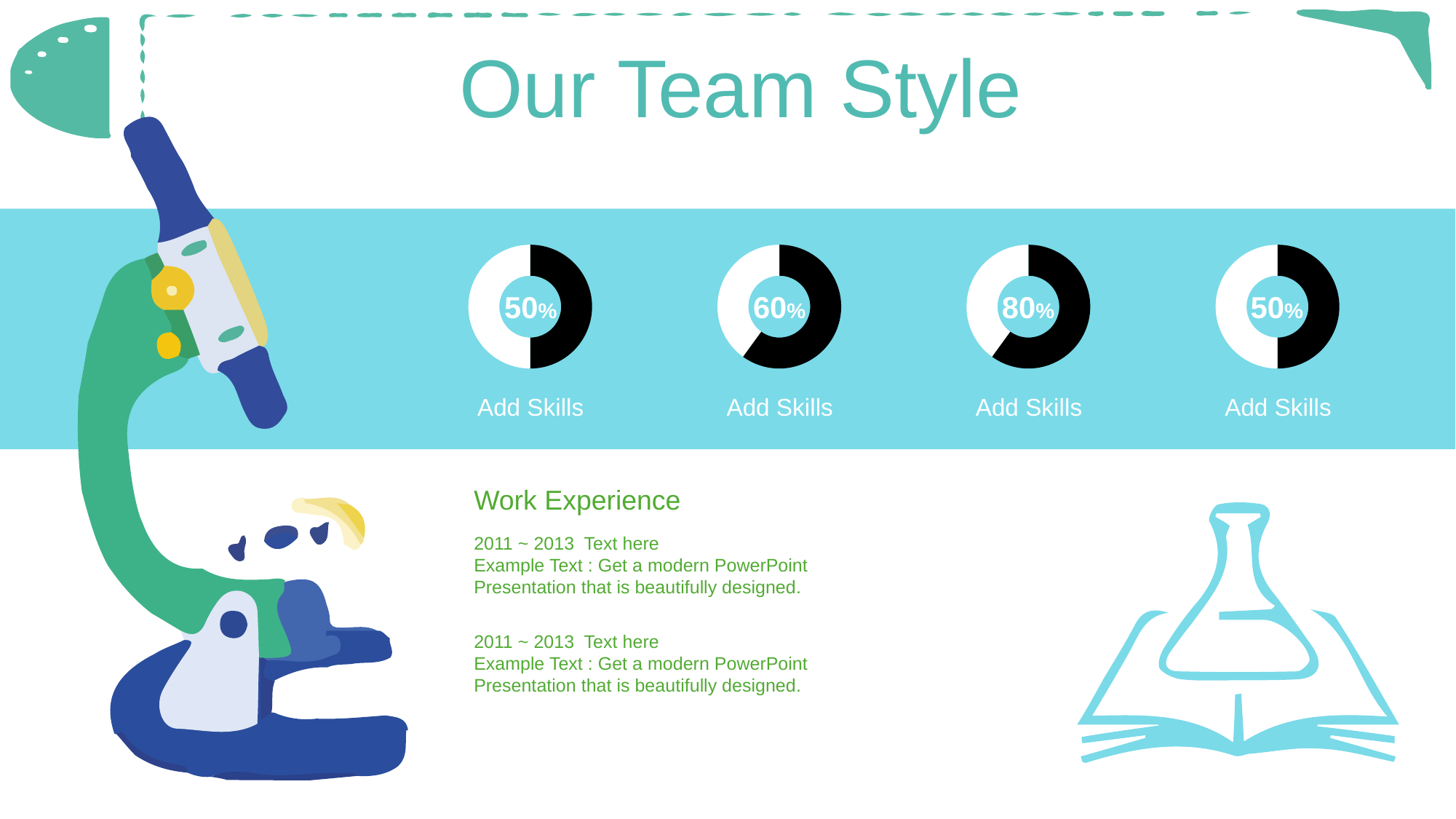
What label appears beneath each of the doughnut charts? Add Skills What kind of chart is the leftmost chart in the blue band? doughnut chart What percentage is shown in the centre of the third doughnut chart from the left? 80% What percentage is shown in the centre of the rightmost doughnut chart? 50% How many doughnut charts are shown on the slide? 4 What percentage is shown in the centre of the second doughnut chart from the left? 60% What colour is the filled portion of each doughnut chart? black What percentage is shown in the centre of the leftmost doughnut chart? 50% What is the difference between the percentage in the third doughnut chart and the percentage in the second doughnut chart? 20% What is the difference between the percentage in the third doughnut chart and the percentage in the rightmost doughnut chart? 30% Which doughnut chart shows the highest percentage, counting from the left? the third Which shows a larger percentage, the second doughnut chart or the leftmost doughnut chart? the second doughnut chart